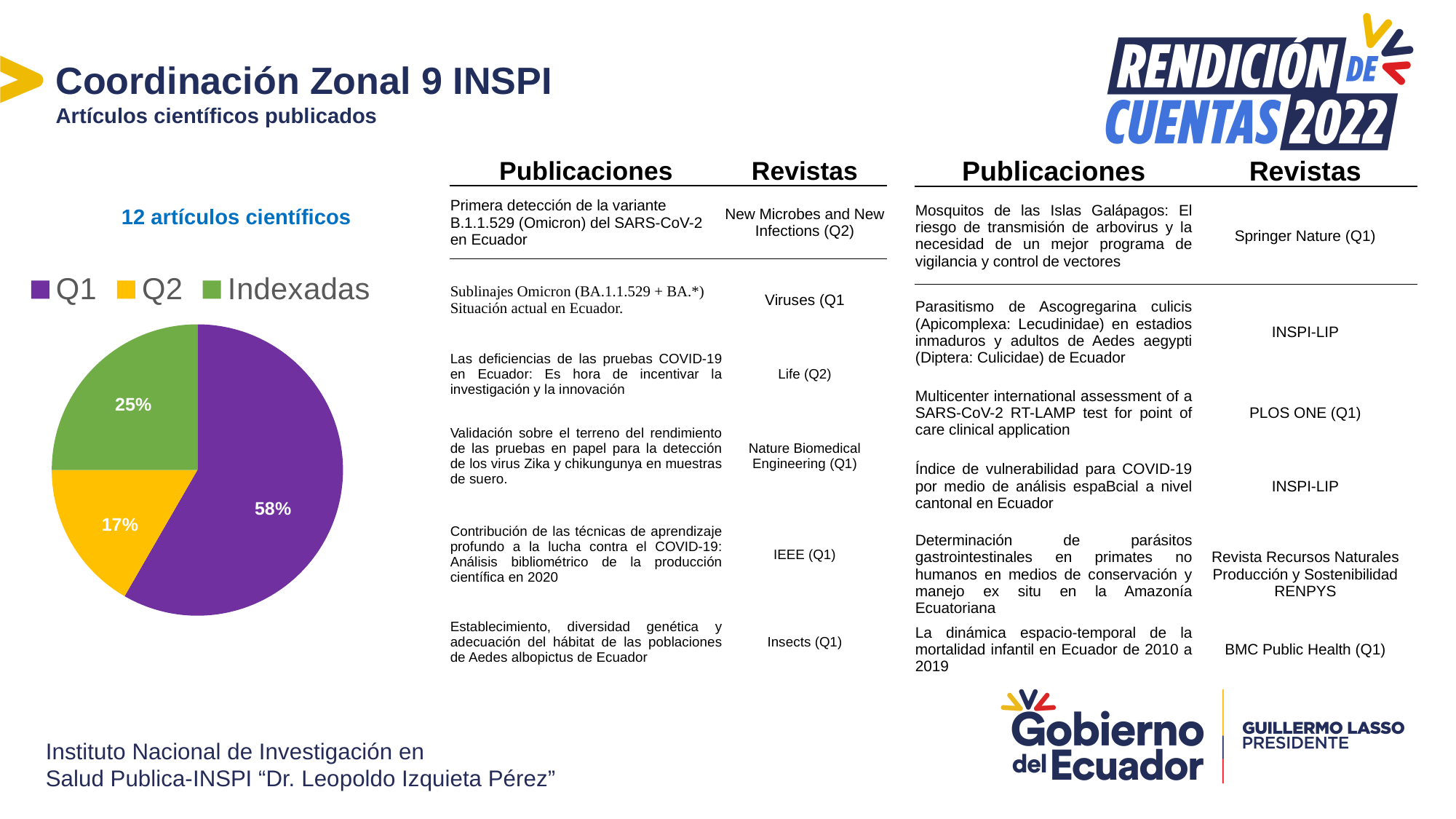
What kind of chart is shown on the slide? pie chart What share of the pie does Indexadas represent? 25% How many slices does the pie chart have? 3 What share of the pie does Q2 represent? 17% What is the difference in percentage points between the Indexadas slice and the Q2 slice? 8 Which category has the largest slice of the pie? Q1 What is the difference in percentage points between the Q1 slice and the Indexadas slice? 33 Which category has the smallest slice of the pie? Q2 How many entries does the chart legend list? 3 Which slice is larger, Q2 or Indexadas? Indexadas What share of the pie does Q1 represent? 58% What colour is the Q2 slice in the pie chart? yellow